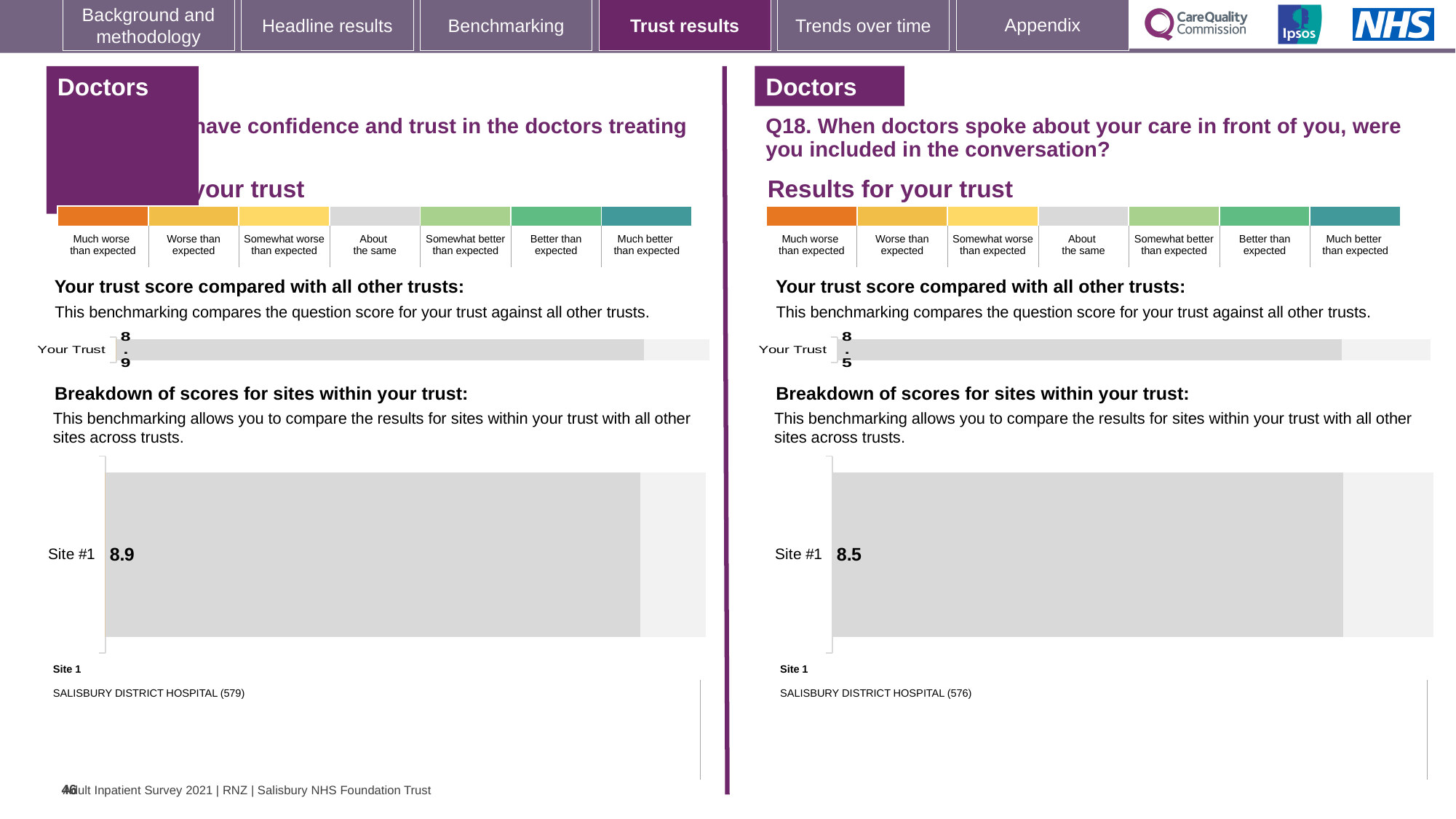
Which is larger: the Your Trust score on the left half of the slide or the Your Trust score for Q18 on the right half? Left half (8.9) On the right half of the slide (Q18), in the 'Your trust score compared with all other trusts' chart, what is the value for Your Trust? 8.5 Which hospital is listed as Site 1 below the breakdown chart on the left half of the slide? SALISBURY DISTRICT HOSPITAL (579) How many sites are shown in the 'Breakdown of scores for sites within your trust' chart on the left half of the slide? 1 On the left half of the slide, in the 'Your trust score compared with all other trusts' chart, what is the value for Your Trust? 8.9 What is the difference between the Site #1 score on the left half of the slide and the Site #1 score for Q18 on the right half? 0.4 How many sites are shown in the 'Breakdown of scores for sites within your trust' chart for Q18 on the right half of the slide? 1 What kind of chart is used to show the Your Trust score on the left half of the slide? Bar chart Which hospital is listed as Site 1 below the breakdown chart for Q18 on the right half of the slide? SALISBURY DISTRICT HOSPITAL (576) On the left half of the slide, in the 'Breakdown of scores for sites within your trust' chart, what is the score for Site #1? 8.9 On the right half of the slide (Q18), in the 'Breakdown of scores for sites within your trust' chart, what is the score for Site #1? 8.5 What kind of chart is used to show the Site #1 score on the right half of the slide? Bar chart